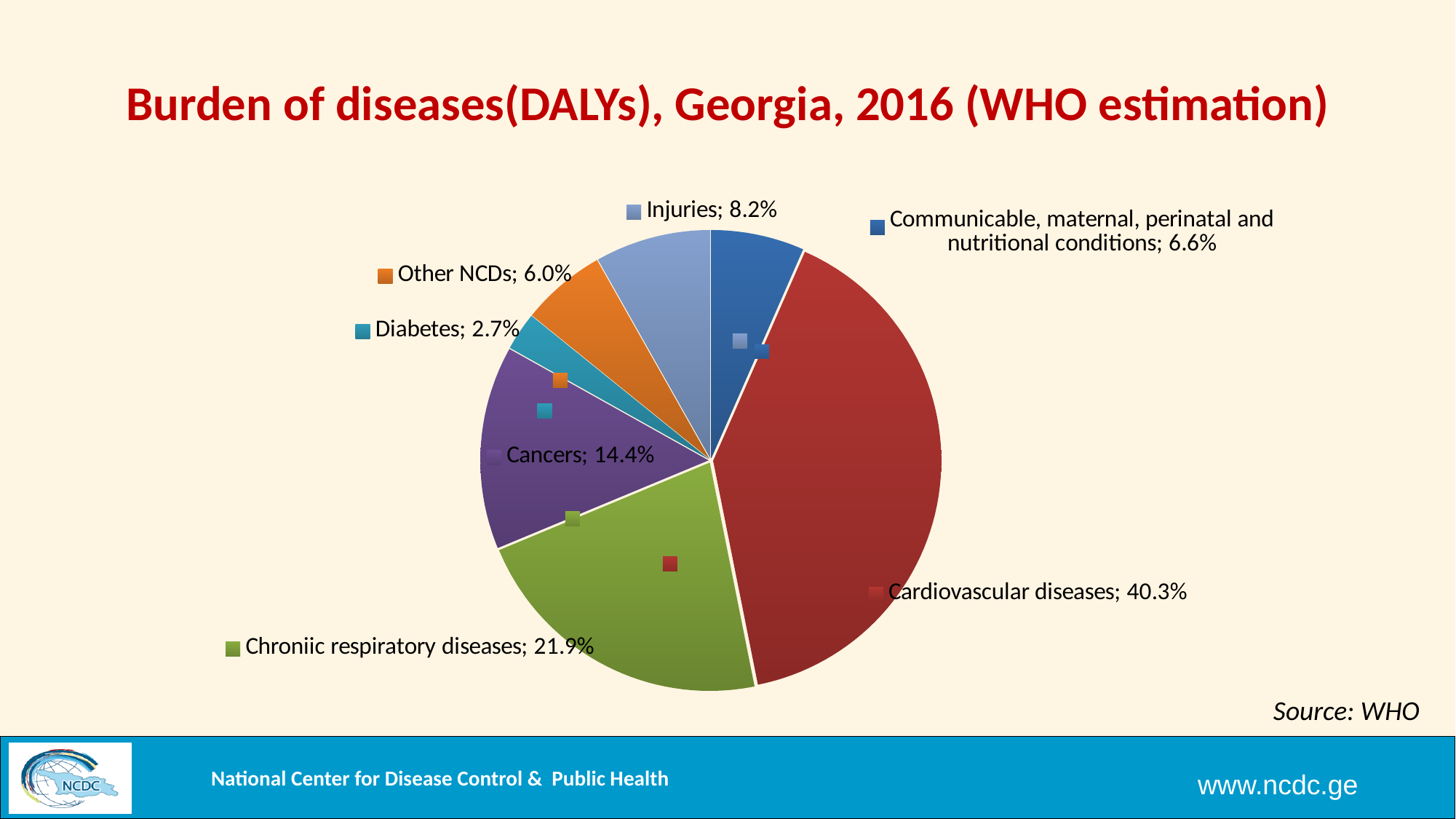
What share of the pie is Cancers? 14.4% Which category has the largest slice of the pie? Cardiovascular diseases What share of the pie is Diabetes? 2.7% How many categories are shown in the pie chart? 7 What kind of chart is shown on the slide? Pie chart What is the difference between the shares for Cardiovascular diseases and Chroniic respiratory diseases? 18.4% What is the title of the chart? Burden of diseases(DALYs), Georgia, 2016 (WHO estimation) What share of the pie is Cardiovascular diseases? 40.3% What share of the pie is Communicable, maternal, perinatal and nutritional conditions? 6.6% Which is larger, the share for Injuries or the share for Other NCDs? Injuries Which category has the smallest slice of the pie? Diabetes What share of the pie is Chroniic respiratory diseases? 21.9%